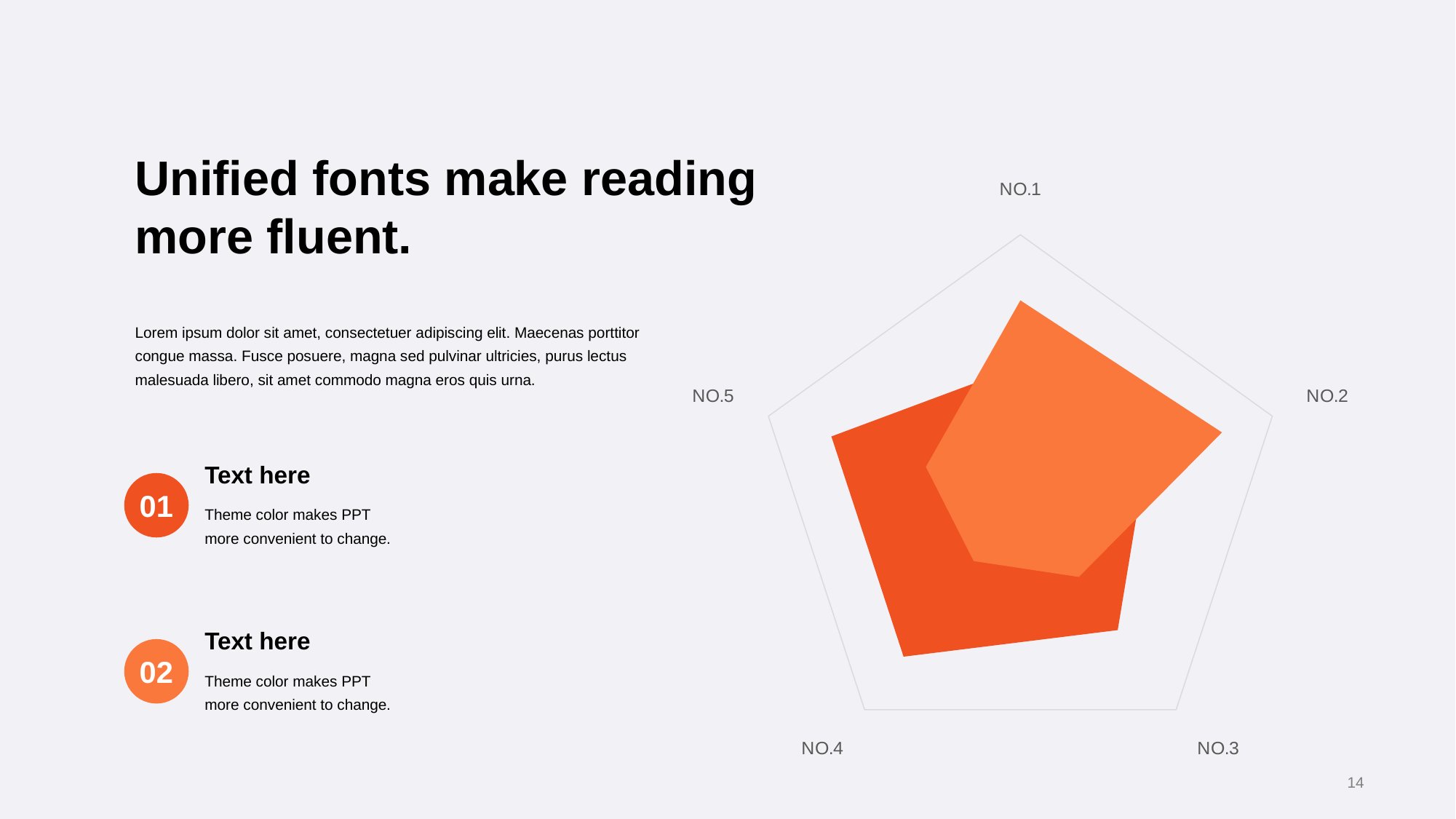
Which category label appears at the top of the radar chart? NO.1 What are the category labels on the radar chart? NO.1, NO.2, NO.3, NO.4, NO.5 At NO.1, which series has the larger value, the lighter orange or the darker orange? lighter orange At NO.4, which series has the larger value, the lighter orange or the darker orange? darker orange For the lighter orange series, is the value for NO.1 larger or smaller than the value for NO.4? larger How many categories (axes) does the radar chart have? 5 How many filled data series are plotted on the radar chart? 2 What kind of chart is shown on the slide? Radar chart